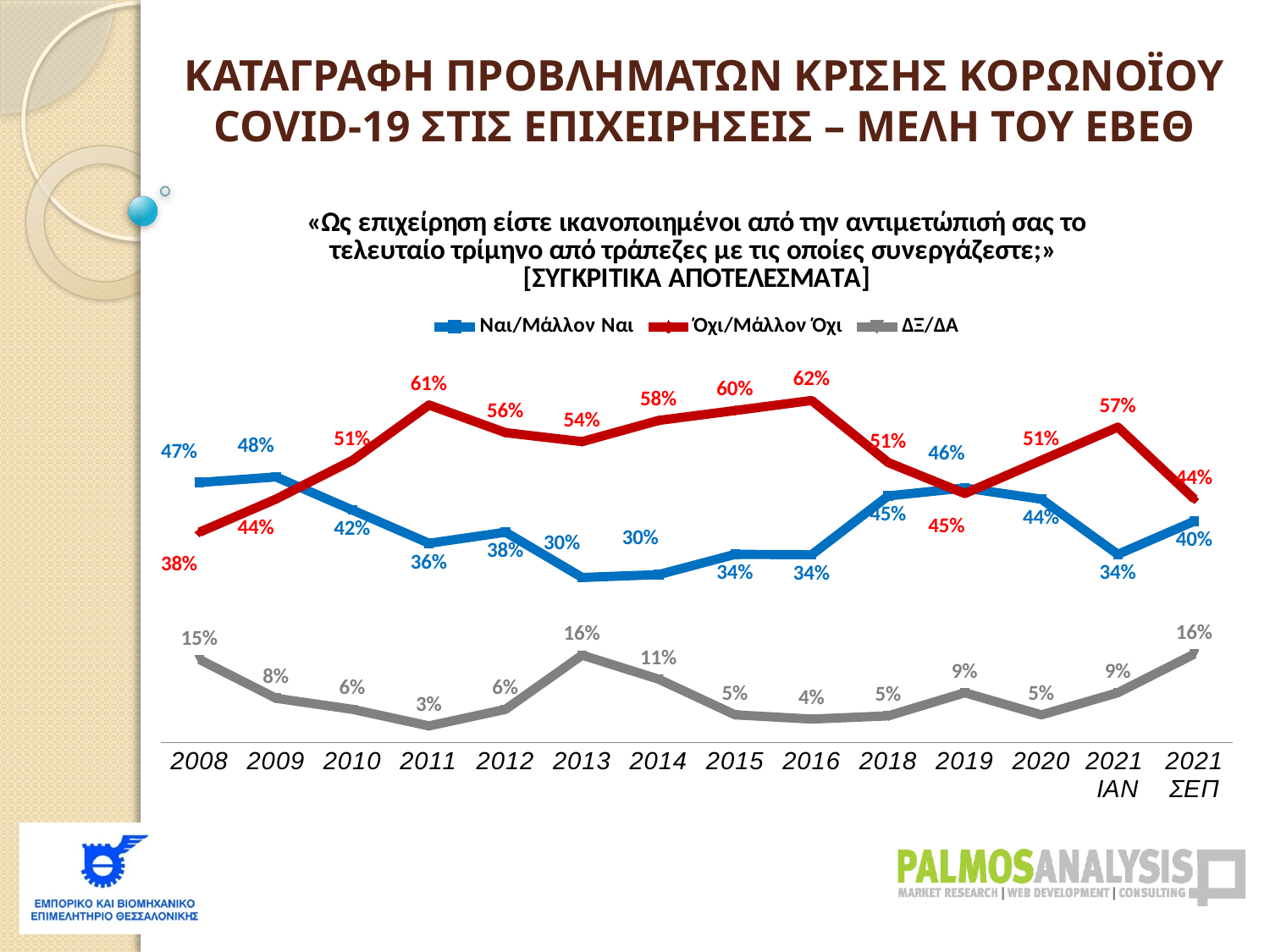
In which year does the ΔΞ/ΔΑ series have its lowest value? 2011 How many time points are shown on the x axis? 14 What type of chart is shown on the slide? line chart What is the value of the ΔΞ/ΔΑ series in 2013? 16% What is the value of the Όχι/Μάλλον Όχι series in 2016? 62% How many series does the legend list? 3 In which year does the Ναι/Μάλλον Ναι series reach its highest value? 2009 In which year does the Όχι/Μάλλον Όχι series reach its highest value? 2016 What is the difference between the Όχι/Μάλλον Όχι and Ναι/Μάλλον Ναι values in 2011? 25% What is the value of the Ναι/Μάλλον Ναι series in 2021 ΣΕΠ? 40% Does the Όχι/Μάλλον Όχι series rise or fall from 2021 ΙΑΝ to 2021 ΣΕΠ? fall Which series has the larger value in 2019, Ναι/Μάλλον Ναι or Όχι/Μάλλον Όχι? Ναι/Μάλλον Ναι